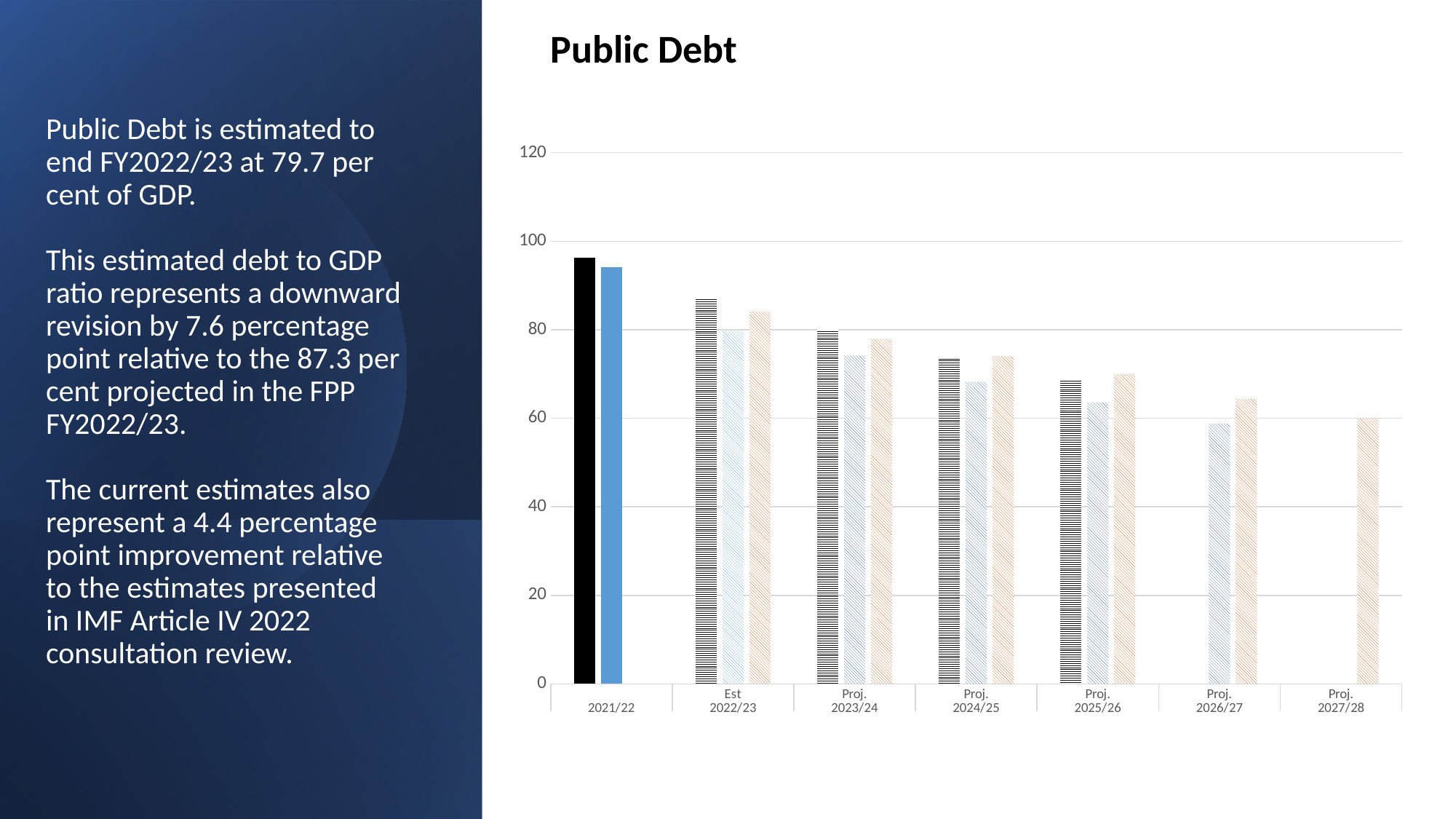
Is the value of the black bar for 2021/22 greater or less than 80? greater How many fiscal-year categories are shown on the x axis of the chart? 7 Is the value of the tallest bar for Est 2022/23 greater or less than 80? greater Which is taller: the black bar for 2021/22 or the black striped bar for Est 2022/23? 2021/22 What kind of chart is shown on the slide? bar chart Which category on the x axis has the tallest bar? 2021/22 Is the value of the blue bar for Proj. 2024/25 greater or less than 80? less How many bars are plotted for the Proj. 2027/28 category? 1 Do the bar heights generally rise or fall moving from 2021/22 to Proj. 2027/28? fall What is the title of the chart? Public Debt